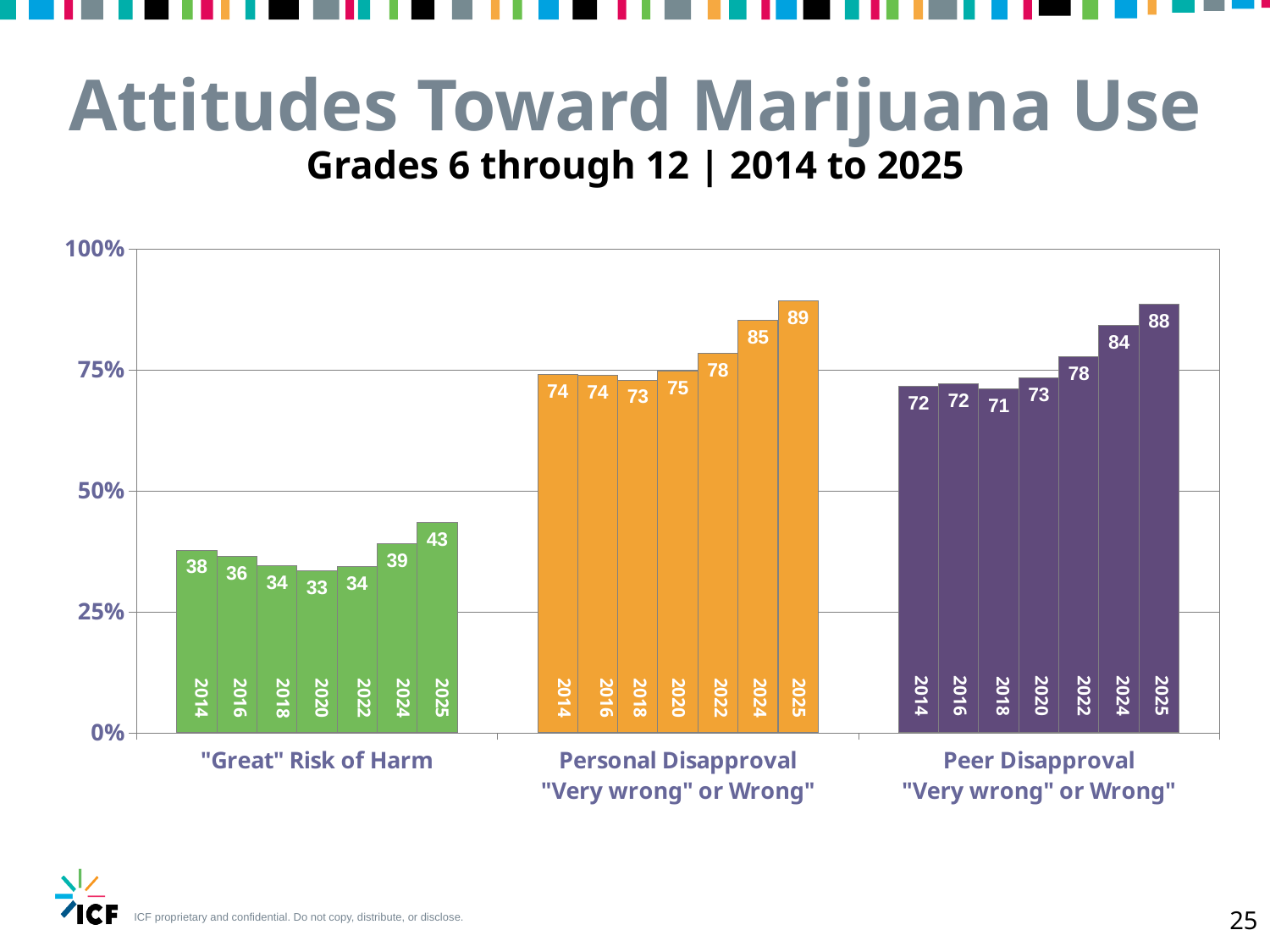
From 2020 to 2025, do the Personal Disapproval values rise or fall? Rise Which year has the lowest value for "Great" Risk of Harm? 2020 What colour are the bars for Peer Disapproval? Purple What is the value for "Great" Risk of Harm in 2025? 43 How many years are shown for each group in the chart? 7 What kind of chart is shown on the slide? Bar chart What is the value for Peer Disapproval in 2018? 71 Which year has the highest value for Personal Disapproval? 2025 Which is larger in 2024: Personal Disapproval or Peer Disapproval? Personal Disapproval What is the difference between the Peer Disapproval values for 2025 and 2014? 16 Is the value for "Great" Risk of Harm in 2025 greater or less than 50%? less What is the value for Personal Disapproval in 2014? 74